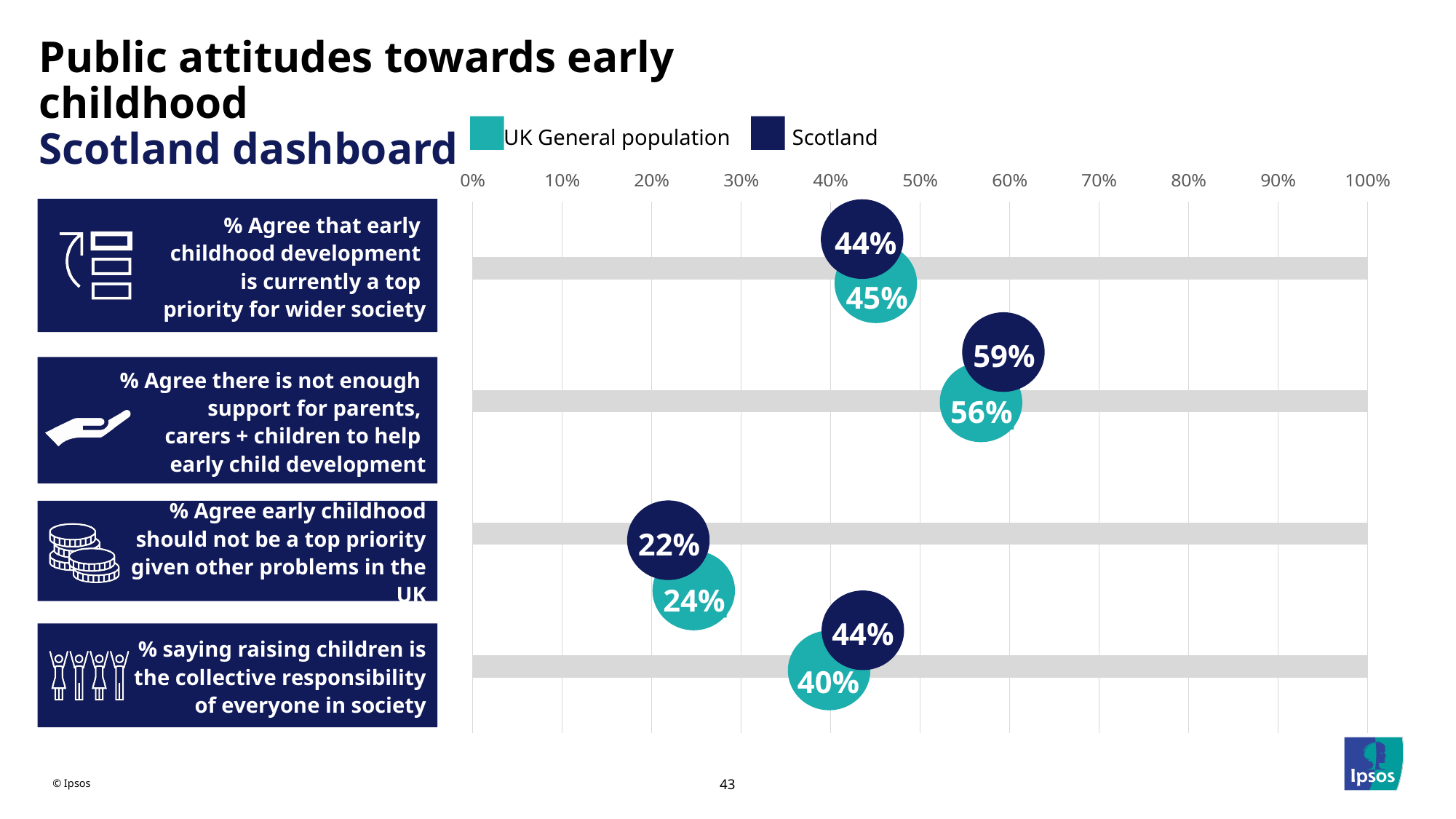
What is the difference between the UK General population and Scotland values for '% Agree there is not enough support for parents, carers + children to help early child development'? 3 percentage points Which statement has the lowest UK General population value? % Agree early childhood should not be a top priority given other problems in the UK What is the Scotland value for '% Agree there is not enough support for parents, carers + children to help early child development'? 59% What is the Scotland value for '% Agree early childhood should not be a top priority given other problems in the UK'? 22% How many statements (categories) are plotted on the chart? 4 What is the difference between the Scotland and UK General population values for '% saying raising children is the collective responsibility of everyone in society'? 4 percentage points What is the UK General population value for '% saying raising children is the collective responsibility of everyone in society'? 40% Which colour represents Scotland in the chart? Dark navy blue What is the UK General population value for '% Agree that early childhood development is currently a top priority for wider society'? 45% How many series does the legend list? 2 For '% Agree there is not enough support for parents, carers + children to help early child development', which is larger: the Scotland value or the UK General population value? Scotland Which statement has the highest Scotland value? % Agree there is not enough support for parents, carers + children to help early child development